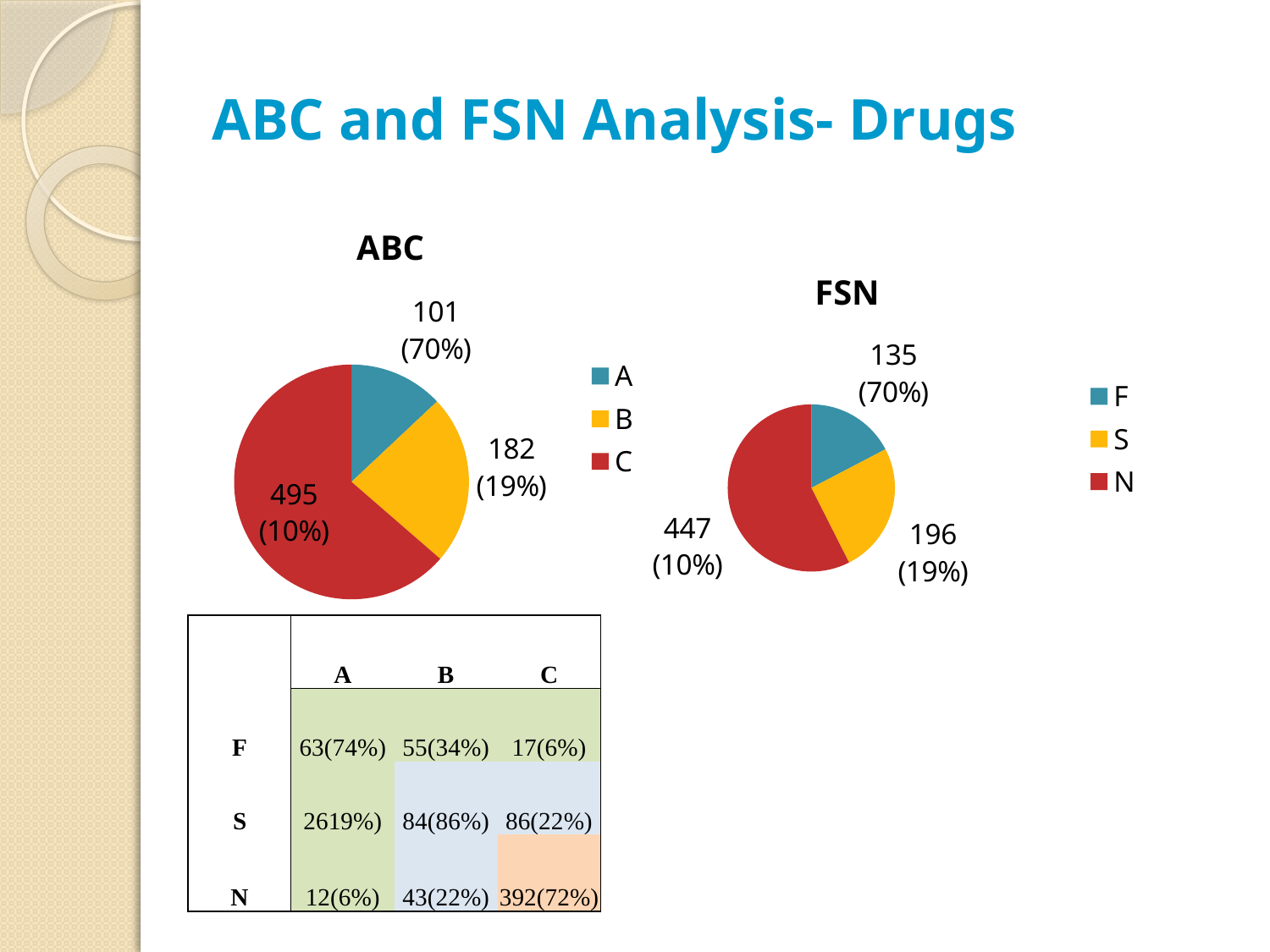
How many categories does the FSN chart show? 3 In the FSN chart, what is the difference between the values for S and F? 61 In the FSN chart, what value is shown for category N? 447 What kind of chart is the ABC chart? Pie chart In the ABC chart, what value is shown for category C? 495 In the FSN chart, what value is shown for category S? 196 In the ABC chart, what is the difference between the values for C and A? 394 In the ABC chart, which category has the largest slice? C In the ABC chart, which is larger, the value for B or the value for A? B In the FSN chart, what colour is the N slice? Red In the ABC chart, what value is shown for category A? 101 In the FSN chart, which category has the smallest slice? F